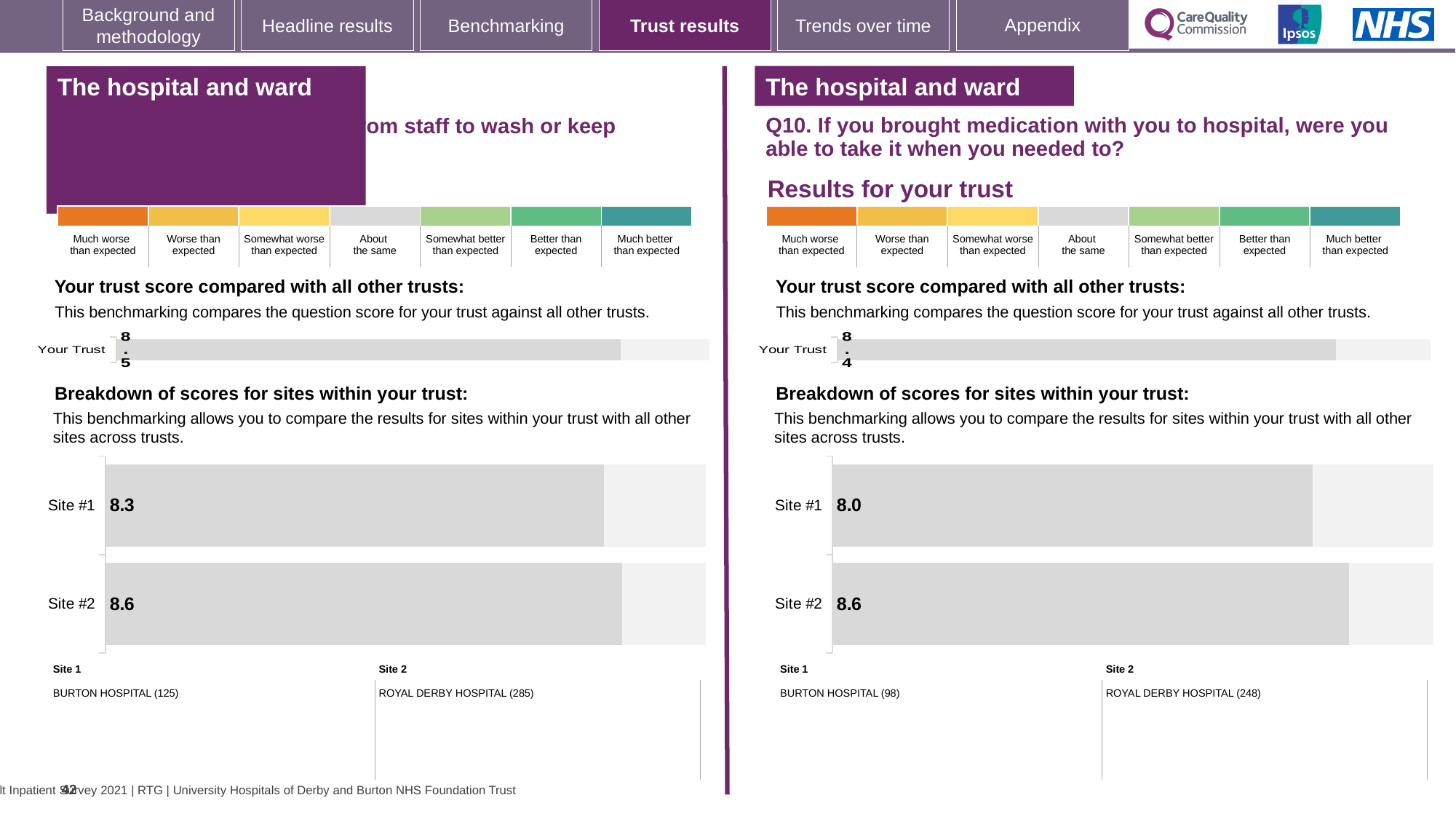
On the right-hand panel (Q10), which site has the higher score in the breakdown of scores for sites within your trust? Site #2 On the left-hand panel, what is the difference between the Site #2 score and the Site #1 score? 0.3 On the left-hand panel, what is the score for Site #2 in the breakdown of scores for sites within your trust? 8.6 What kind of chart is used for the breakdown of scores for sites within your trust on the right-hand panel (Q10)? Bar chart On the right-hand panel (Q10), what is the score for Site #1 in the breakdown of scores for sites within your trust? 8.0 On the right-hand panel (Q10), what is the score for Site #2 in the breakdown of scores for sites within your trust? 8.6 On the left-hand panel, which site has the lower score in the breakdown of scores for sites within your trust? Site #1 On the right-hand panel (Q10), what is the 'Your Trust' score compared with all other trusts? 8.4 On the left-hand panel, what is the 'Your Trust' score compared with all other trusts? 8.5 On the left-hand panel, what is the score for Site #1 in the breakdown of scores for sites within your trust? 8.3 On the right-hand panel (Q10), what is the difference between the Site #2 score and the Site #1 score? 0.6 How many sites are shown in the breakdown of scores chart on the right-hand panel (Q10)? 2